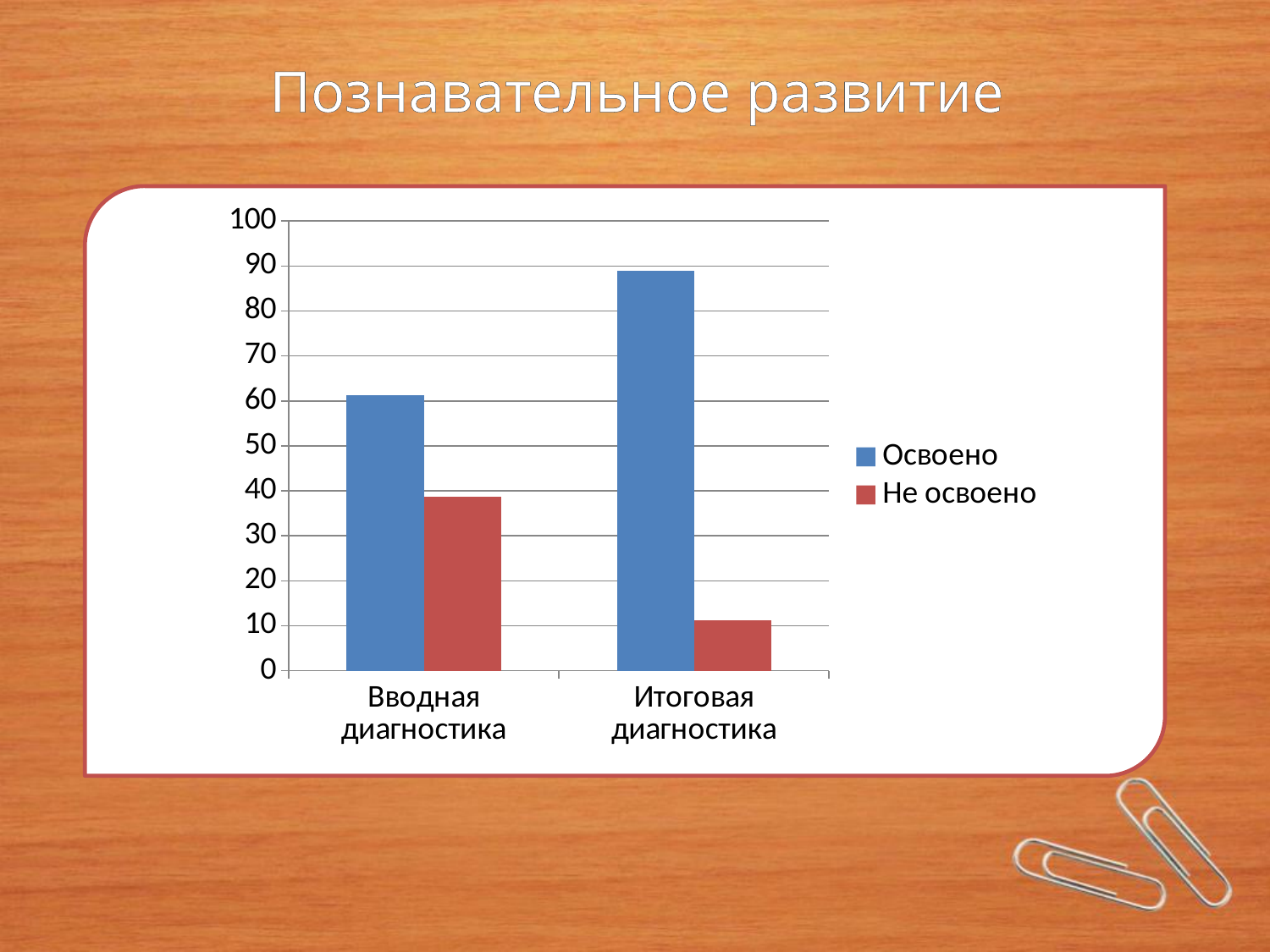
Is the value for Не освоено in Вводная диагностика greater or less than 50? less Does the Не освоено series rise or fall from Вводная диагностика to Итоговая диагностика? fall How many series does the legend list? 2 Which series and category has the tallest bar? Освоено, Итоговая диагностика Which series and category has the shortest bar? Не освоено, Итоговая диагностика Which is larger: Освоено in Вводная диагностика or Освоено in Итоговая диагностика? Освоено in Итоговая диагностика Is the value for Освоено in Вводная диагностика greater or less than 50? greater Is the value for Не освоено in Итоговая диагностика greater or less than 20? less What kind of chart is shown on the slide? bar chart What colour are the bars for the Освоено series? blue How many categories are shown on the x axis? 2